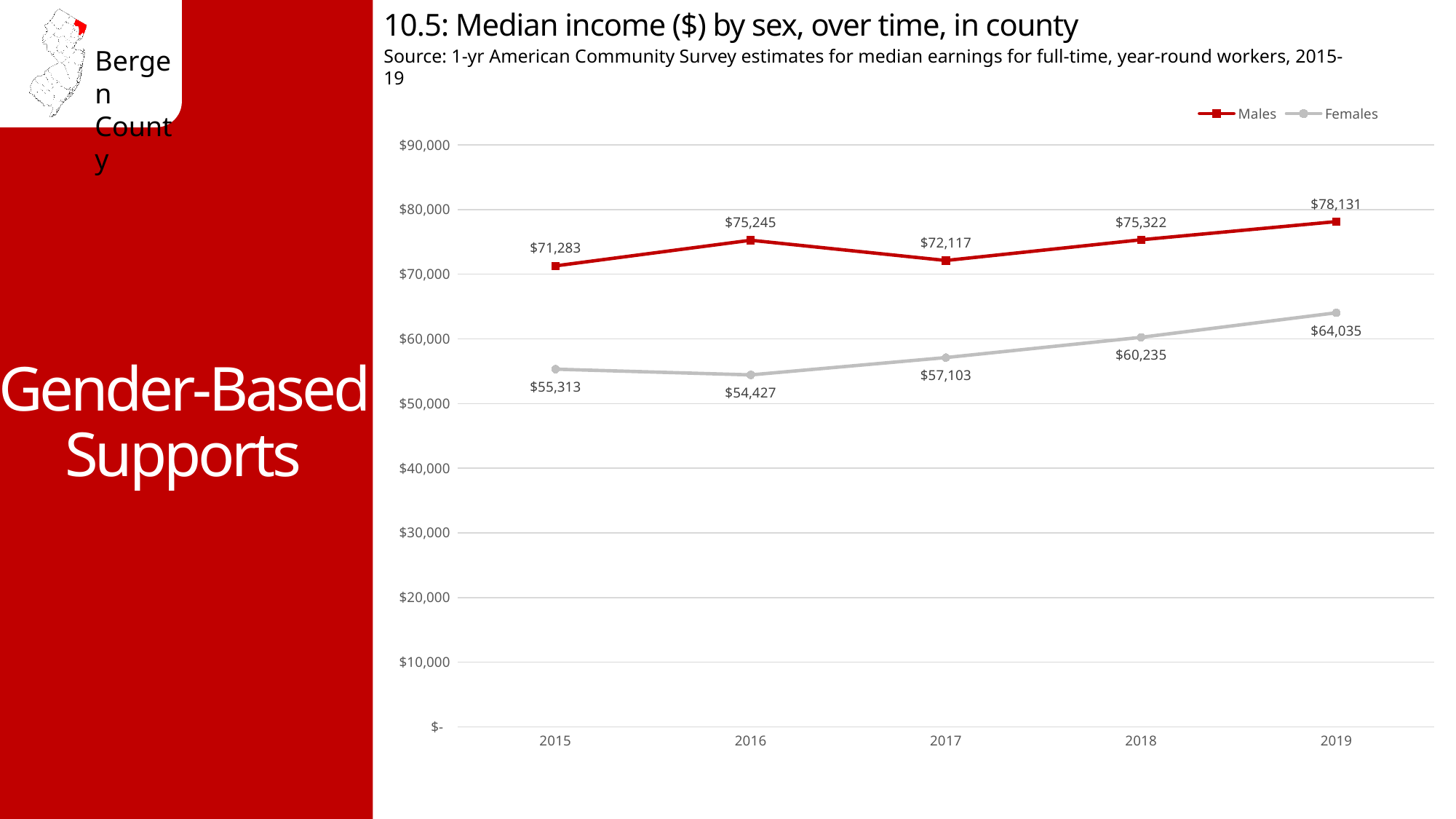
What is the median income for Females in 2016? $54,427 In which year is the median income for Males lowest? 2015 What is the median income for Males in 2017? $72,117 How many series does the legend list? 2 What is the difference between the Males and Females median income in 2019? $14,096 What kind of chart is shown? line chart Which is larger: the Males median income in 2016 or in 2018? 2018 What colour is the Males line? red Does the Females median income rise or fall from 2016 to 2019? rise In which year is the median income for Females highest? 2019 How many years are shown on the x axis? 5 Is the Females median income in 2018 greater or less than $70,000? less